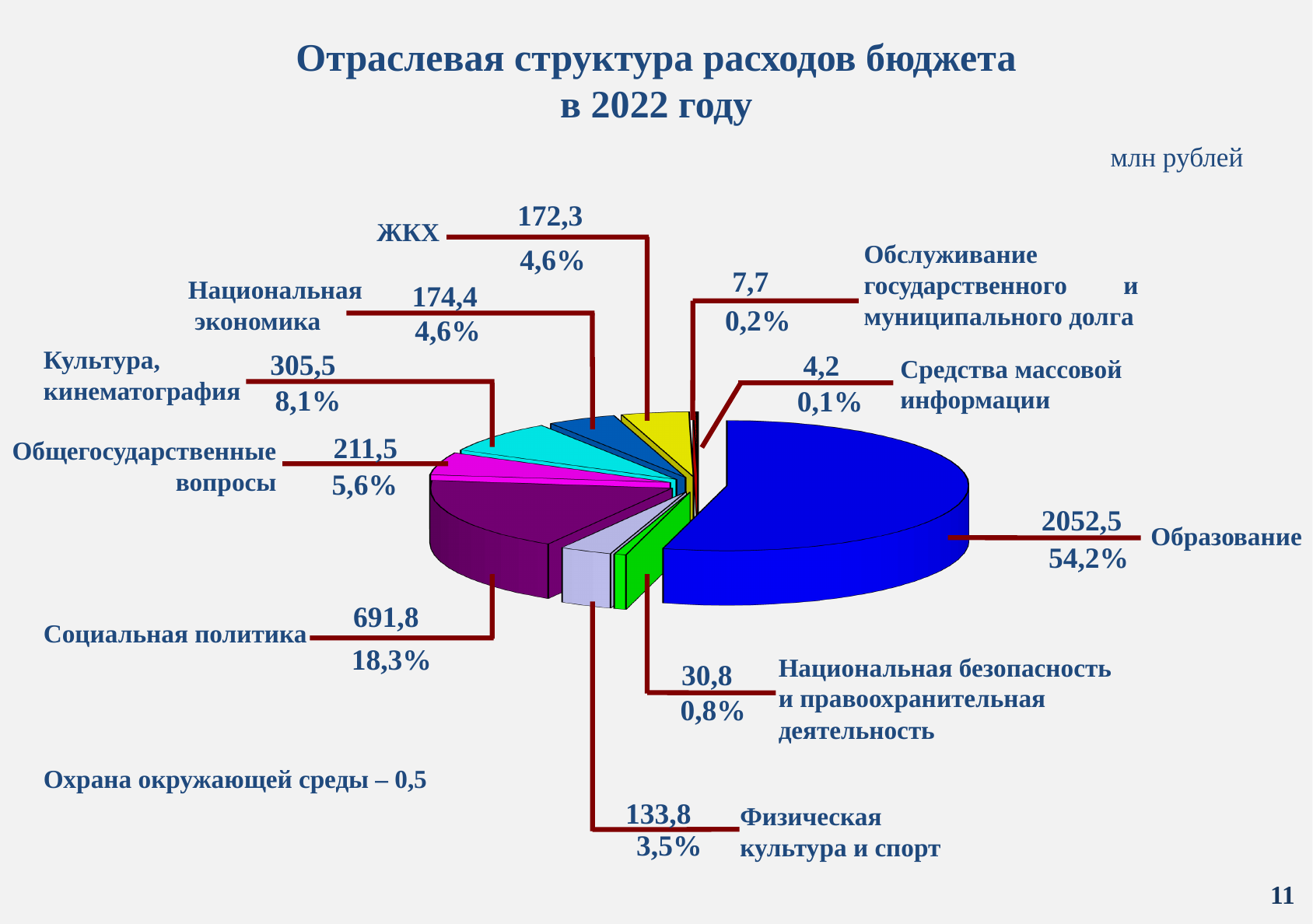
In what units are the values on the chart given? млн рублей What percentage share does Культура, кинематография have? 8,1% What is the difference between the values for Национальная экономика and ЖКХ? 2,1 Which category has the smallest percentage share shown on the chart? Средства массовой информации What is the value for Физическая культура и спорт? 133,8 What kind of chart is shown on the slide? pie chart What is the value for Образование? 2052,5 What is the value for Социальная политика? 691,8 What is the difference between the values for Образование and Социальная политика? 1360,7 Which category has the largest share of the pie? Образование Which is larger, the value for Культура, кинематография or for Общегосударственные вопросы? Культура, кинематография What percentage share does Образование have in the pie? 54,2%